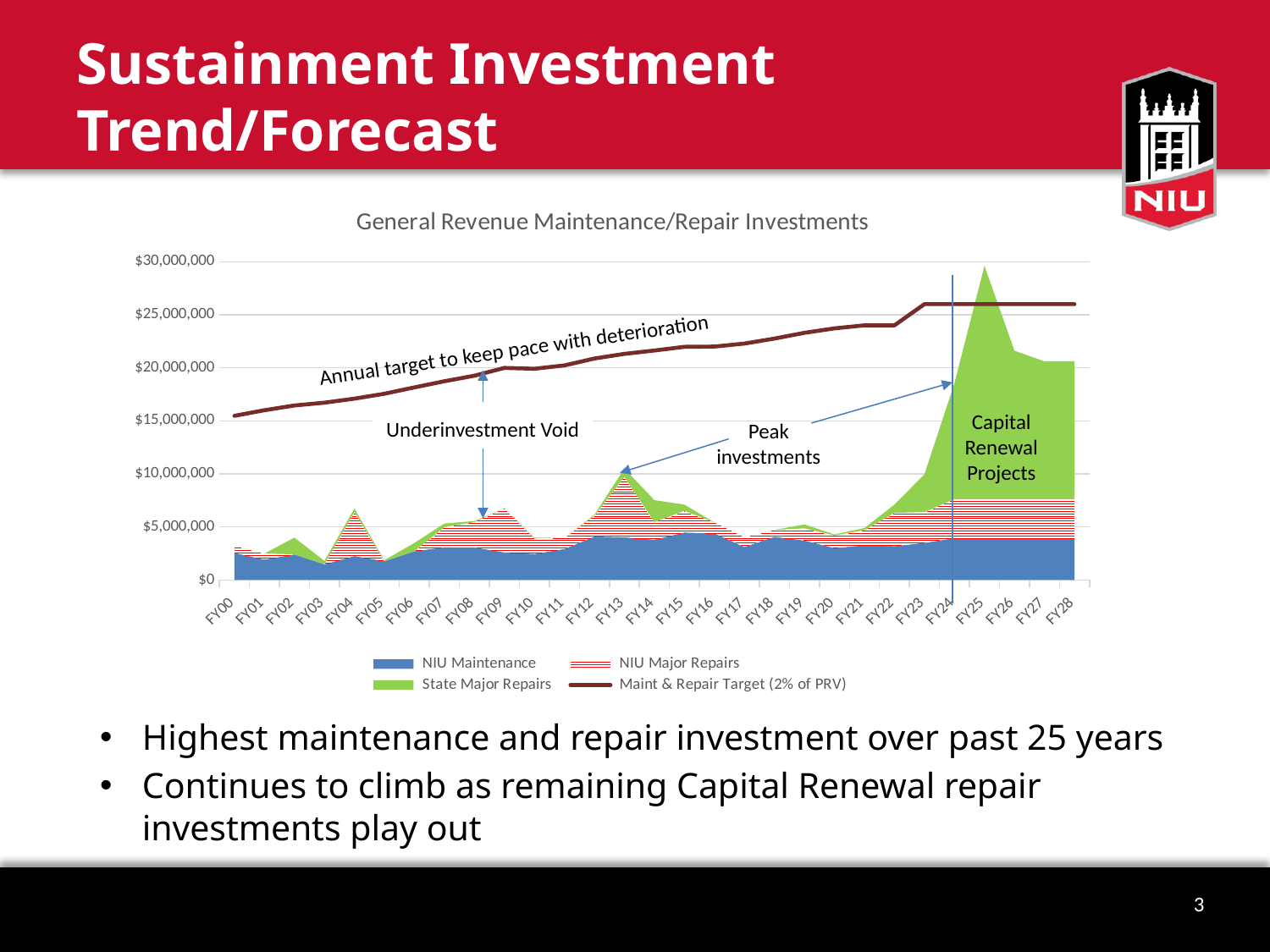
Is the Maint & Repair Target value for FY00 greater or less than $15,000,000? greater Does the Maint & Repair Target line rise or fall from FY00 to FY28? Rises Is the total stacked investment for FY03 greater or less than $5,000,000? less In which fiscal year does the total stacked investment reach its highest point? FY25 What is the title of the chart? General Revenue Maintenance/Repair Investments How many series does the legend list? 4 What kind of chart is shown on the slide? Stacked area chart with a line Is the Maint & Repair Target value for FY28 greater or less than $25,000,000? greater Which series is drawn as a dark red line rather than a filled area? Maint & Repair Target (2% of PRV) Which is larger, the total stacked investment in FY25 or in FY13? FY25 How many fiscal years are plotted along the x axis? 29